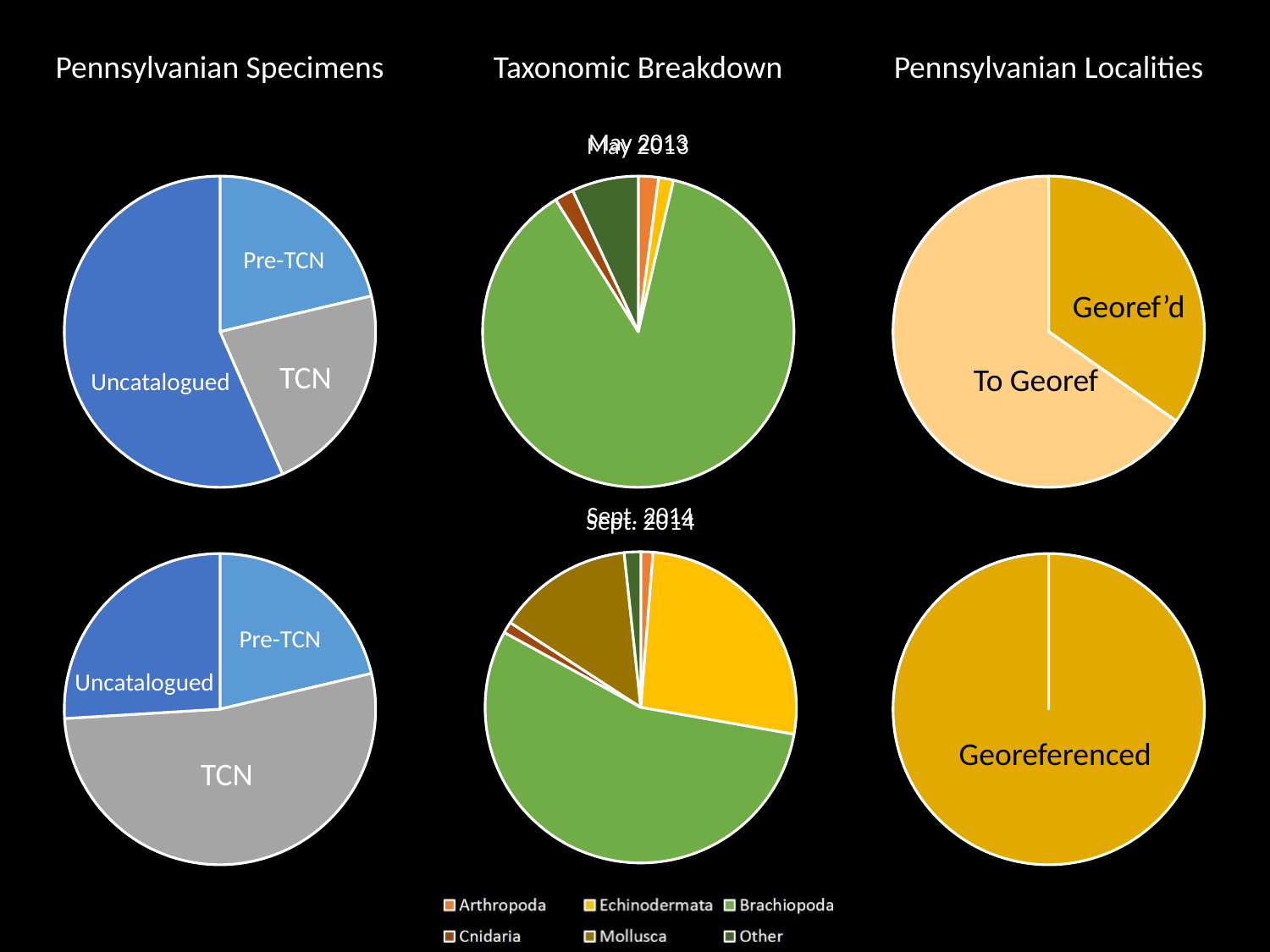
In the Pennsylvanian Specimens Sept. 2014 pie chart, which category has the largest slice? TCN In the Taxonomic Breakdown Sept. 2014 pie chart, which taxon has the largest slice? Brachiopoda In the Taxonomic Breakdown Sept. 2014 pie chart, which slice is larger, Echinodermata or Mollusca? Echinodermata Which legend entry for the Taxonomic Breakdown charts is shown in yellow? Echinodermata How many slices does the Pennsylvanian Specimens May 2013 pie chart have? 3 What is the only category shown in the Pennsylvanian Localities Sept. 2014 pie chart? Georeferenced How many entries does the legend for the Taxonomic Breakdown charts list? 6 What kind of chart is used for the Pennsylvanian Specimens May 2013 chart? Pie chart In the Pennsylvanian Specimens May 2013 pie chart, which category has the largest slice? Uncatalogued How many slices does the Pennsylvanian Localities Sept. 2014 pie chart have? 1 In the Pennsylvanian Localities May 2013 pie chart, which slice is larger, Georef'd or To Georef? To Georef